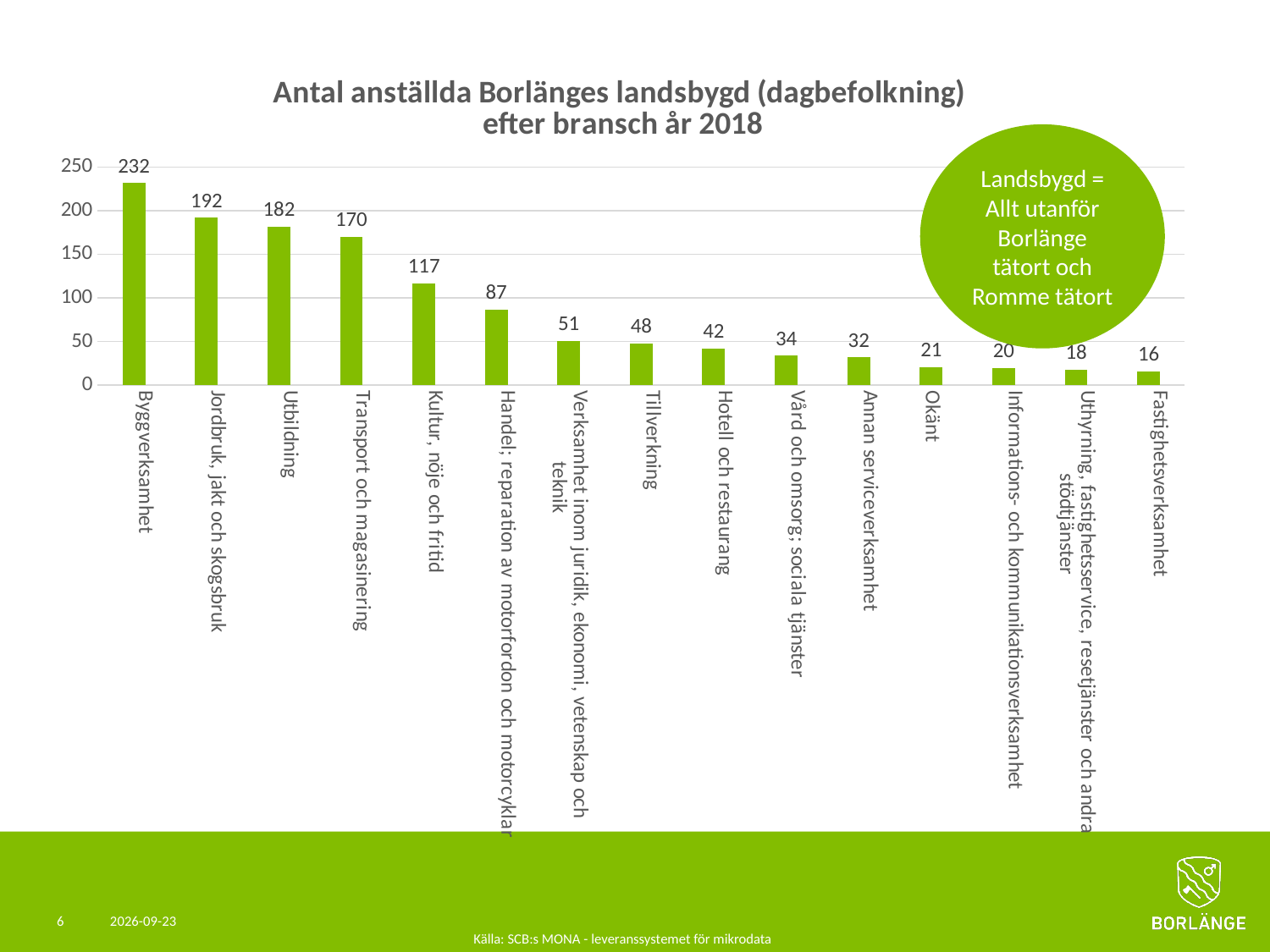
What is the value shown for Hotell och restaurang? 42 Which has a larger value, Tillverkning or Kultur, nöje och fritid? Kultur, nöje och fritid Is the value for Transport och magasinering greater or less than 150? greater Do the values rise or fall from left to right along the x axis? Fall How many industry categories are shown in the chart? 15 What is the value shown for Utbildning? 182 Which industry has the lowest number of employees? Fastighetsverksamhet What is the difference between the values for Byggverksamhet and Jordbruk, jakt och skogsbruk? 40 What is the number of employees for Byggverksamhet? 232 Which industry has the highest number of employees? Byggverksamhet What is the title of the chart? Antal anställda Borlänges landsbygd (dagbefolkning) efter bransch år 2018 What kind of chart is shown on the slide? Bar chart